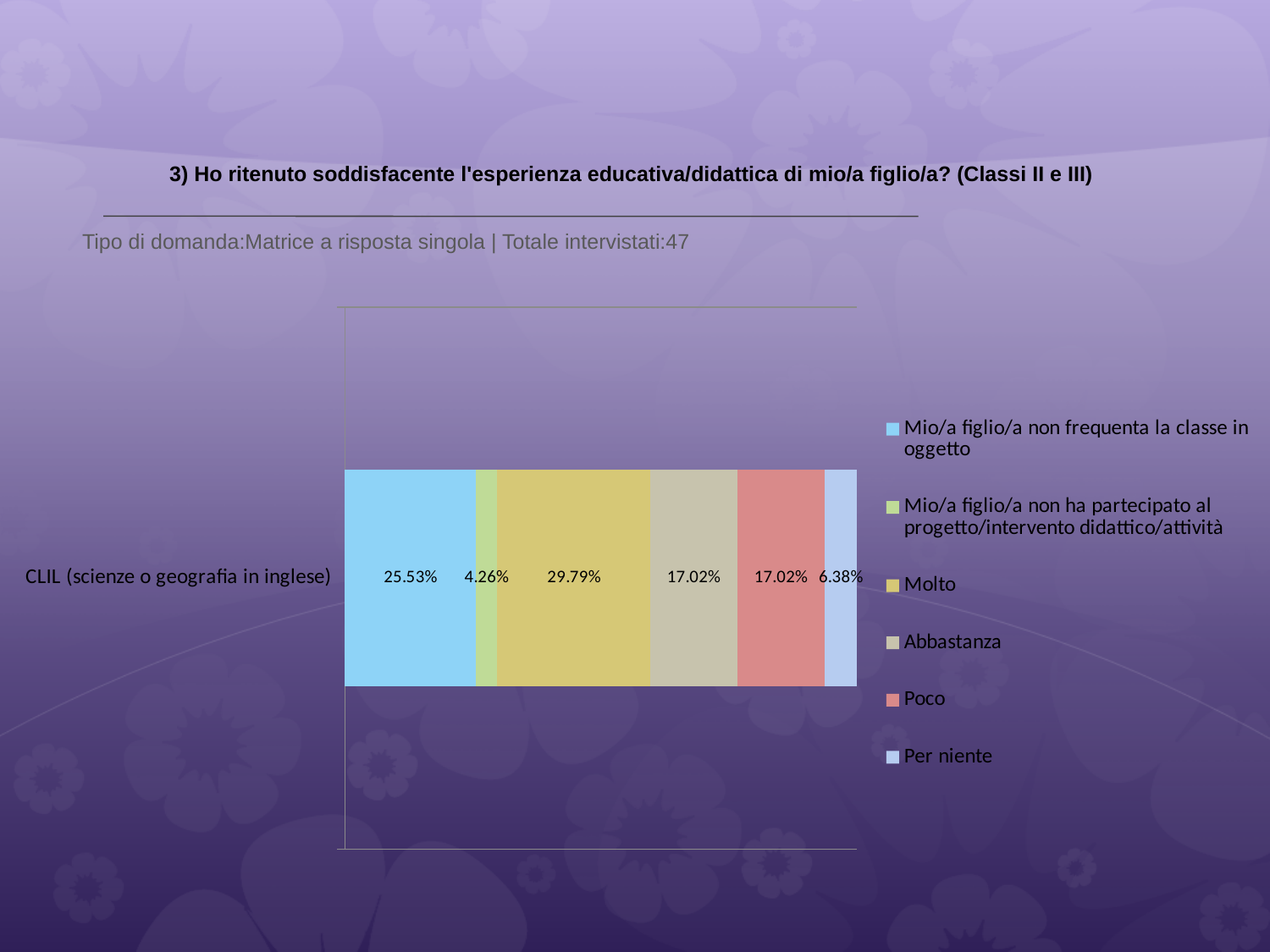
What is the value for "Per niente"? 6.38% What is the value for "Molto" for CLIL (scienze o geografia in inglese)? 29.79% What kind of chart is shown on the slide? Stacked bar chart How many series does the legend list? 6 Which series has the highest value in the bar? Molto What is the value for "Abbastanza"? 17.02% What is the value for "Mio/a figlio/a non ha partecipato al progetto/intervento didattico/attività"? 4.26% What is the difference between the values for "Molto" and "Poco"? 12.77% How many categories are plotted on the chart? 1 Which series has the lowest value in the bar? Mio/a figlio/a non ha partecipato al progetto/intervento didattico/attività Which is larger, the value for "Mio/a figlio/a non frequenta la classe in oggetto" or the value for "Abbastanza"? Mio/a figlio/a non frequenta la classe in oggetto What is the value for "Mio/a figlio/a non frequenta la classe in oggetto"? 25.53%